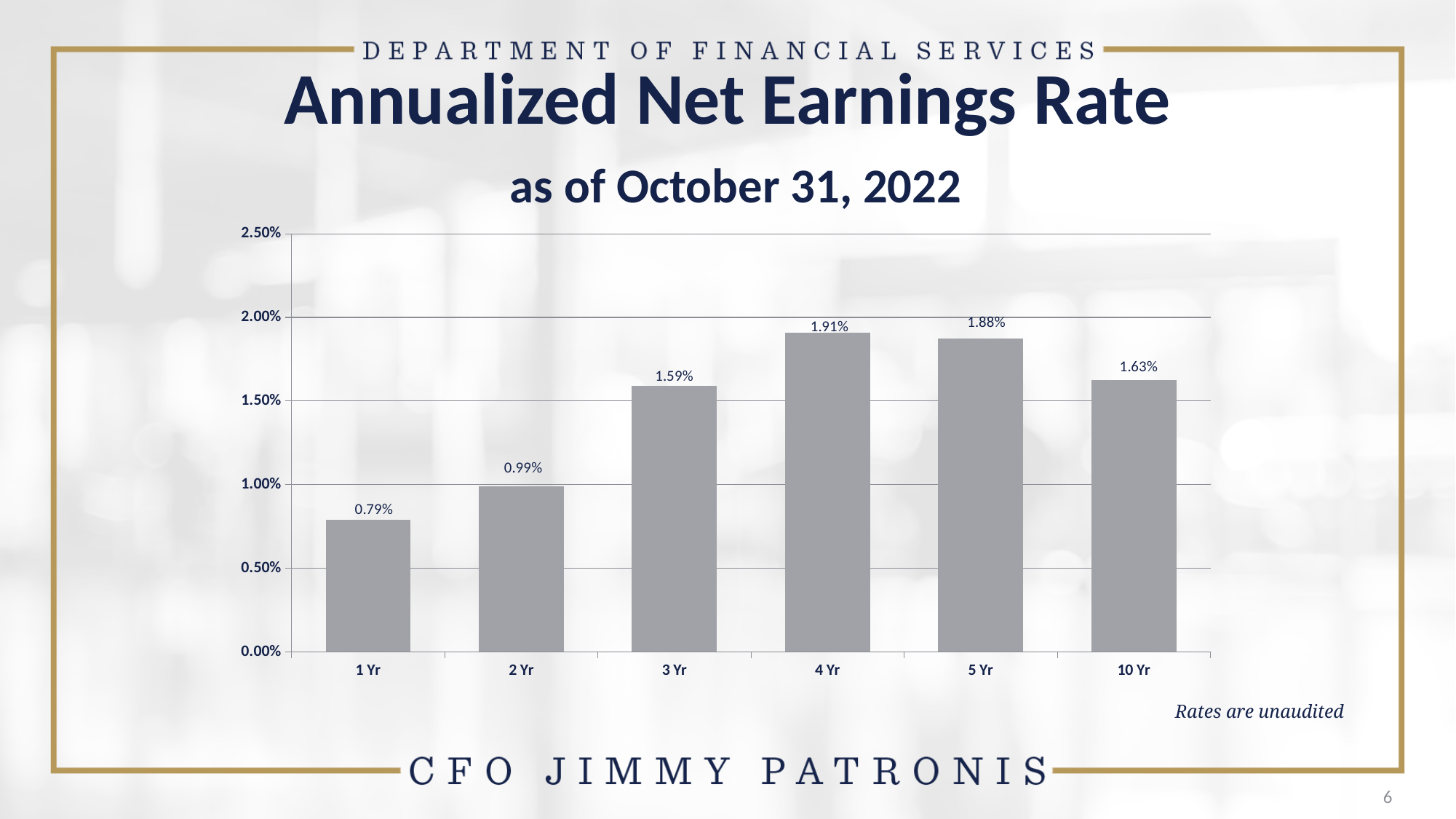
Which period has the highest annualized net earnings rate? 4 Yr What is the annualized net earnings rate for 3 Yr? 1.59% What is the title of the chart on the slide? Annualized Net Earnings Rate as of October 31, 2022 What is the annualized net earnings rate for 1 Yr? 0.79% What kind of chart is shown on the slide? Bar chart What is the difference between the 4 Yr rate and the 1 Yr rate? 1.12% What is the annualized net earnings rate for 10 Yr? 1.63% How many periods are shown on the chart? 6 Which is larger, the 3 Yr rate or the 10 Yr rate? 10 Yr Is the value for 2 Yr greater or less than 1.00%? less What is the difference between the 2 Yr rate and the 1 Yr rate? 0.20% Which period has the lowest annualized net earnings rate? 1 Yr